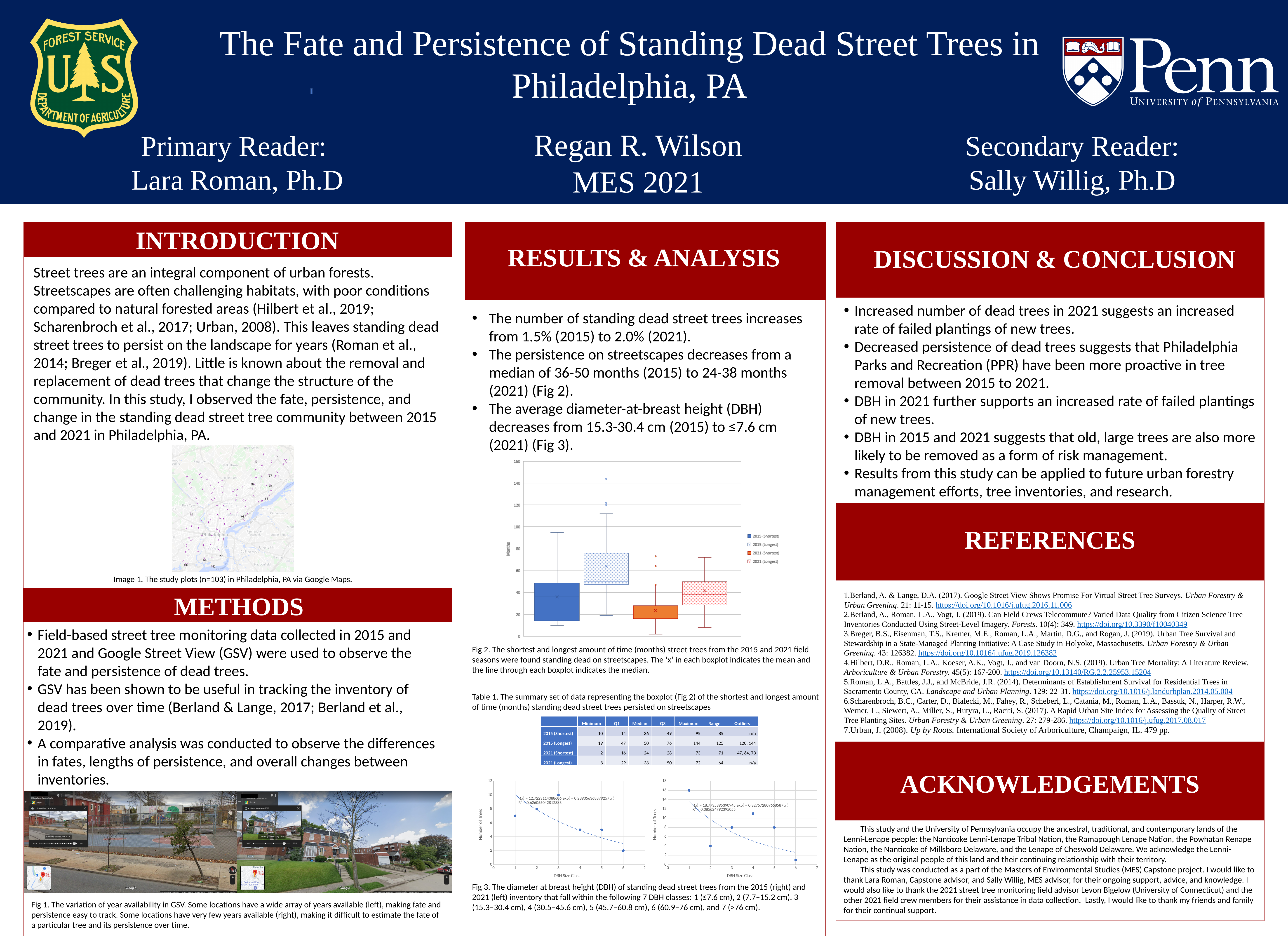
In Fig 2, is the median for 2015 (Longest) greater or less than 40? greater In the right-hand scatter plot of Fig 3 (2015), which DBH size class has the highest number of trees? 1 What are the legend entries in Fig 2? 2015 (Shortest), 2015 (Longest), 2021 (Shortest), 2021 (Longest) What kind of chart is Fig 2 (the chart of months standing dead)? box plot In Fig 2, is the highest outlier for 2015 (Longest) greater or less than 120? greater In the left-hand scatter plot of Fig 3 (2021), which DBH size class has the highest number of trees? 3 How many series does the legend of Fig 2 list? 4 In the right-hand scatter plot of Fig 3 (2015), how many data points are plotted? 6 In Fig 2, which series has the highest maximum value? 2015 (Longest) According to Table 1, what is the median for 2021 (Longest)? 38 What is the y-axis label of Fig 2? Months In Fig 2, which has the larger median: 2015 (Shortest) or 2021 (Shortest)? 2015 (Shortest)